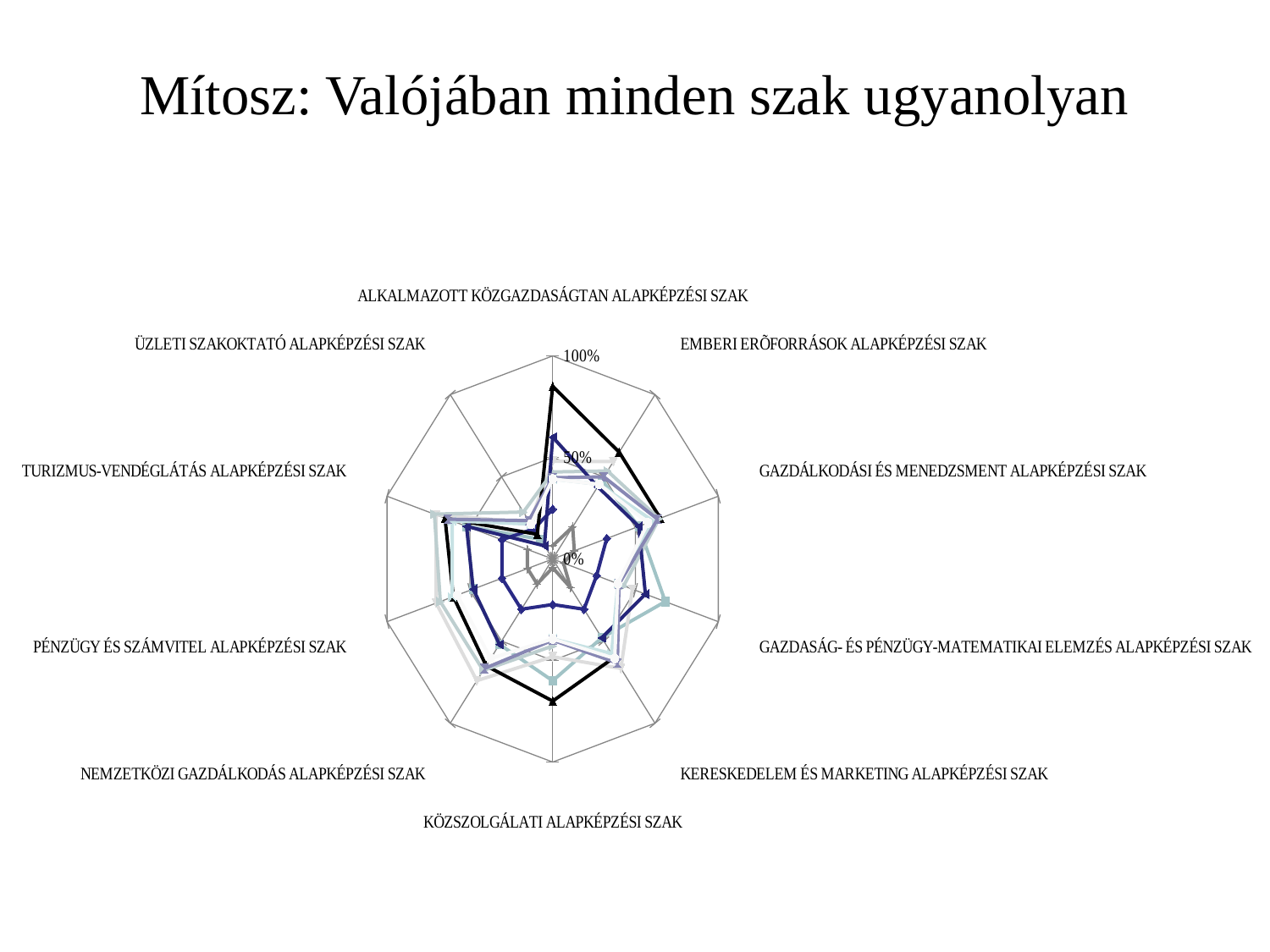
Is the value of the black line for GAZDÁLKODÁSI ÉS MENEDZSMENT ALAPKÉPZÉSI SZAK greater or less than 50%? greater What is the maximum value labelled on the radar chart's axis? 100% For the black line, which category has the highest value? ALKALMAZOTT KÖZGAZDASÁGTAN ALAPKÉPZÉSI SZAK Is the value of the dark blue line for KÖZSZOLGÁLATI ALAPKÉPZÉSI SZAK greater or less than 50%? less Is the value of the black line for KÖZSZOLGÁLATI ALAPKÉPZÉSI SZAK greater or less than 50%? greater How many categories (axes) does the radar chart have? 10 For the black line, which is larger: the value for ALKALMAZOTT KÖZGAZDASÁGTAN ALAPKÉPZÉSI SZAK or the value for EMBERI ERŐFORRÁSOK ALAPKÉPZÉSI SZAK? ALKALMAZOTT KÖZGAZDASÁGTAN ALAPKÉPZÉSI SZAK What is the title of the slide containing the radar chart? Mítosz: Valójában minden szak ugyanolyan Which category label appears at the top of the radar chart? ALKALMAZOTT KÖZGAZDASÁGTAN ALAPKÉPZÉSI SZAK What kind of chart is shown on the slide? Radar chart